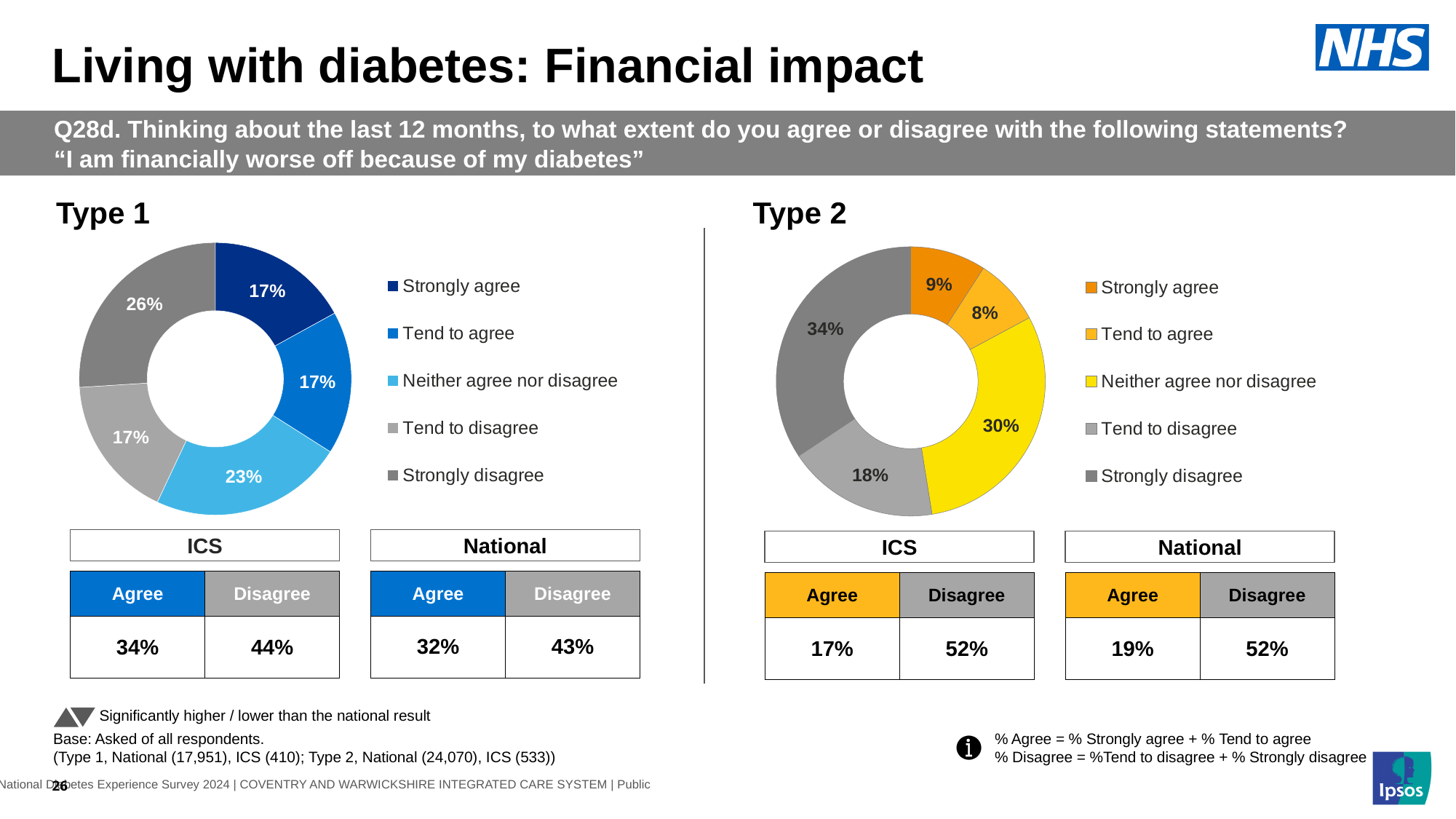
In the Type 2 chart, what percentage of respondents said 'Strongly agree'? 9% Which is larger: the 'Strongly disagree' share in the Type 1 chart or in the Type 2 chart? Type 2 In the Type 1 chart, which response category has the largest share? Strongly disagree In the Type 1 chart, what is the difference between the 'Strongly disagree' share and the 'Neither agree nor disagree' share? 3 percentage points In the Type 2 chart, what is the difference between the 'Neither agree nor disagree' share and the 'Strongly agree' share? 21 percentage points How many response categories does the legend of the Type 2 chart list? 5 What kind of chart is used for the Type 1 results? Doughnut chart In the Type 2 chart, which response category has the smallest share? Tend to agree In the Type 1 chart, what percentage of respondents said 'Strongly disagree'? 26% In the Type 2 chart, which response category has the largest share? Strongly disagree In the Type 1 chart, what percentage of respondents said 'Neither agree nor disagree'? 23% In the Type 2 chart, what percentage of respondents said 'Tend to disagree'? 18%